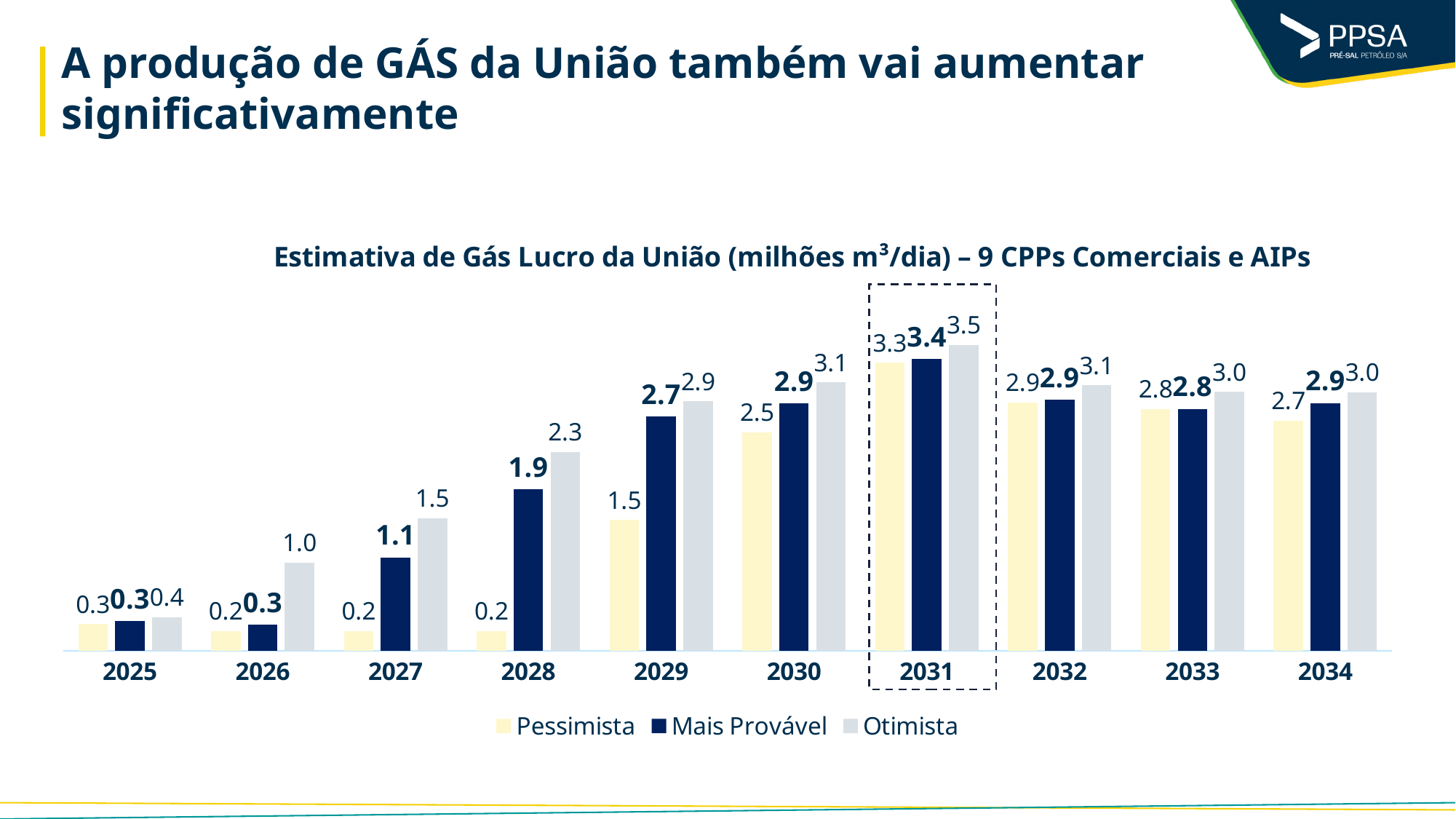
How many years are shown on the x axis? 10 In which year is the Otimista value highest? 2031 What is the Mais Provável value for 2031? 3.4 Which year is highlighted with a dashed box on the chart? 2031 What is the Pessimista value for 2029? 1.5 In which year is the Mais Provável value lowest? 2025 and 2026 What kind of chart is shown on the slide? Bar chart Which is larger, the Mais Provável value for 2027 or the Pessimista value for 2029? Pessimista value for 2029 What is the difference between the Otimista and Pessimista values for 2028? 2.1 What is the Otimista value for 2028? 2.3 What is the Otimista value for 2026? 1.0 How many series does the legend list? 3